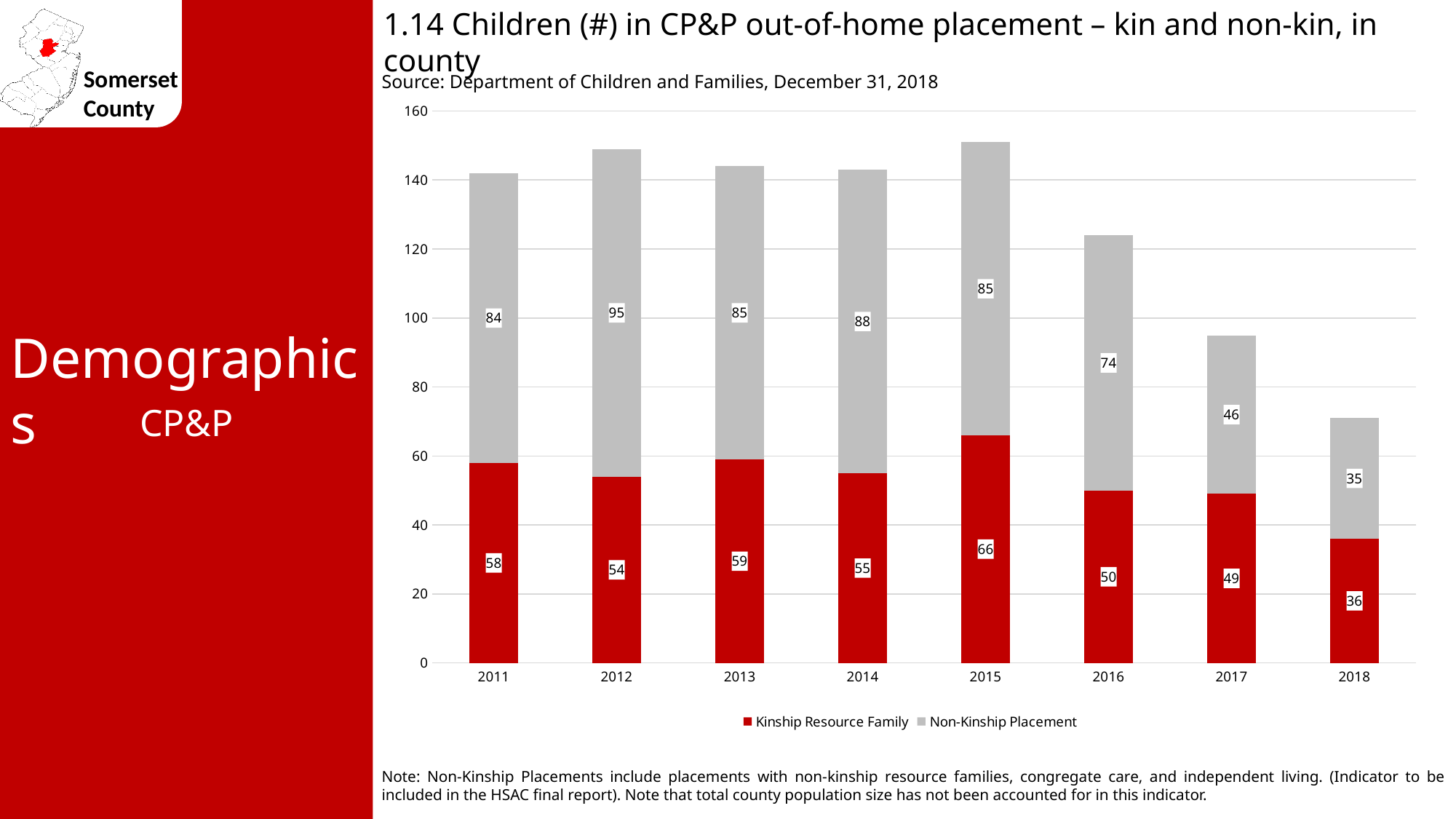
What is the total of the stacked bar for 2018? 71 Which year has the lowest Kinship Resource Family value? 2018 Which is larger, the Kinship Resource Family value for 2013 or for 2014? 2013 What is the Kinship Resource Family value for 2015? 66 What is the total of the stacked bar for 2017? 95 What is the difference between the Non-Kinship Placement values for 2015 and 2016? 11 What kind of chart is shown on the slide? Stacked bar chart What is the Non-Kinship Placement value for 2012? 95 How many years are shown on the x axis? 8 Which year has the highest Non-Kinship Placement value? 2012 What is the Kinship Resource Family value for 2018? 36 How many series does the legend list? 2